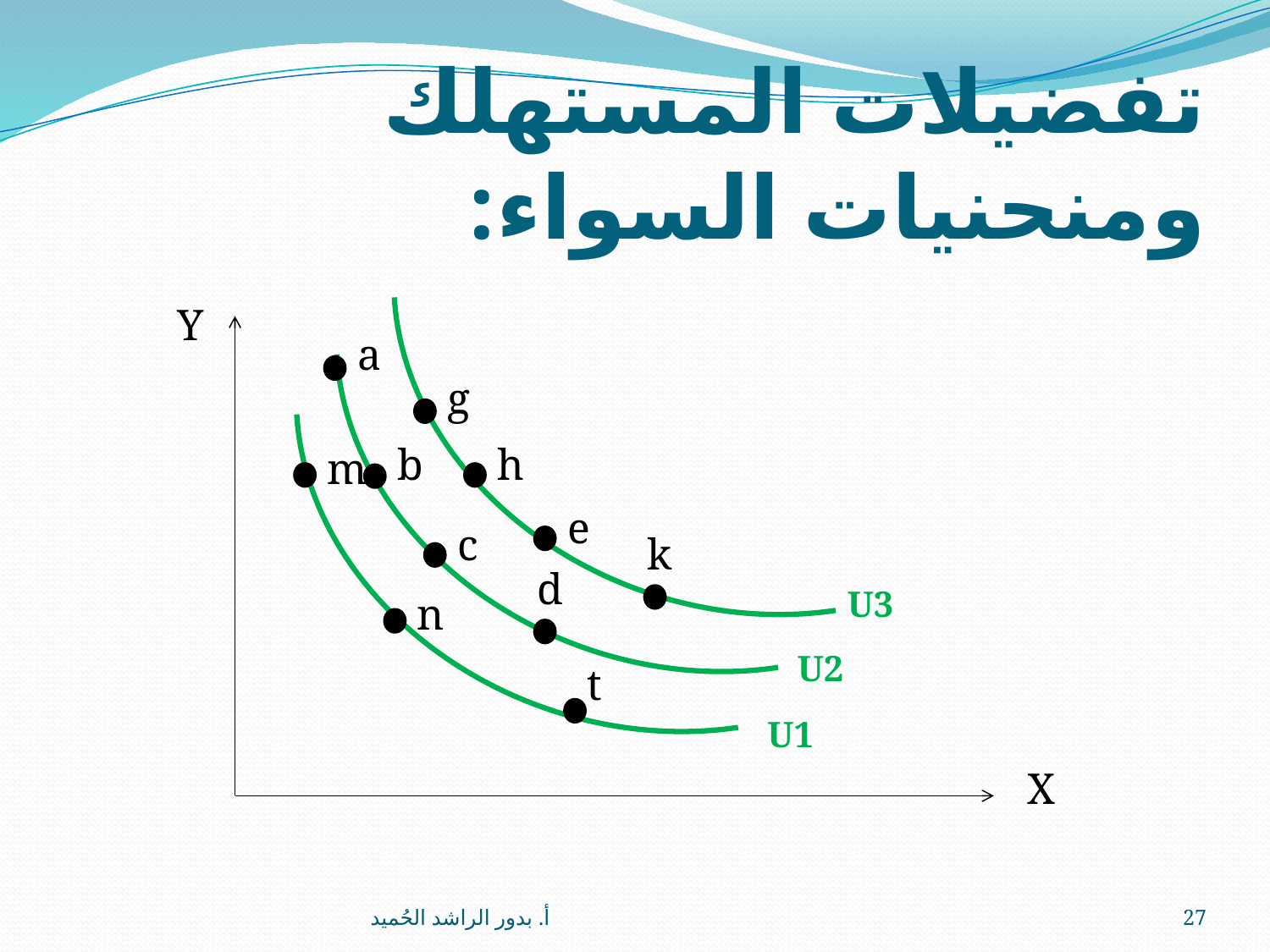
Which curve does point k lie on? U3 Which curve lies farthest from the origin (highest on the chart)? U3 What is the label of the horizontal axis? X As X increases, do the curves rise or fall? fall How many labelled points are plotted on the chart? 11 Which of points k and m has the larger X value? k Which curve does point t lie on? U1 Which of points a and t has the larger Y value? a How many indifference curves are labelled on the chart? 3 What are the labels of the curves shown on the chart? U1, U2, U3 What is the label of the vertical axis? Y Which curve lies closest to the origin (lowest on the chart)? U1